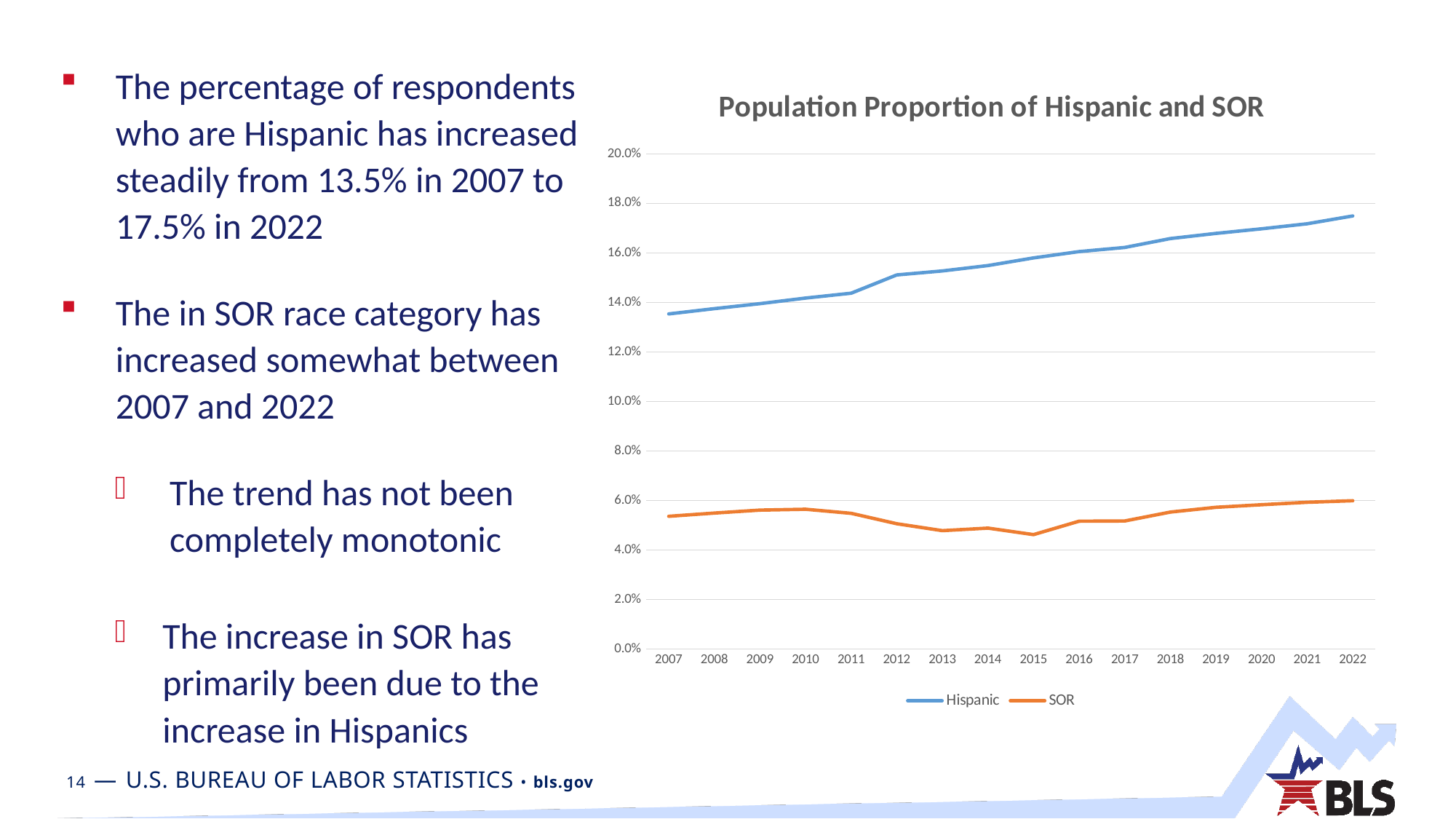
By how many percentage points did the Hispanic proportion increase from 2007 to 2022? 4.0 percentage points How many years are plotted along the x axis of the chart? 16 What kind of chart is shown on the slide? Line chart What is the Hispanic population proportion in 2007? 13.5% In which year is the SOR proportion lowest? 2015 Is the SOR value for 2015 greater or less than 5.0%? less Does the Hispanic line rise or fall from 2007 to 2022? Rises Is the Hispanic value for 2012 greater or less than 14.0%? greater How many series does the chart's legend list? 2 In which year is the Hispanic proportion highest? 2022 What is the Hispanic population proportion in 2022? 17.5% What is the title of the chart? Population Proportion of Hispanic and SOR